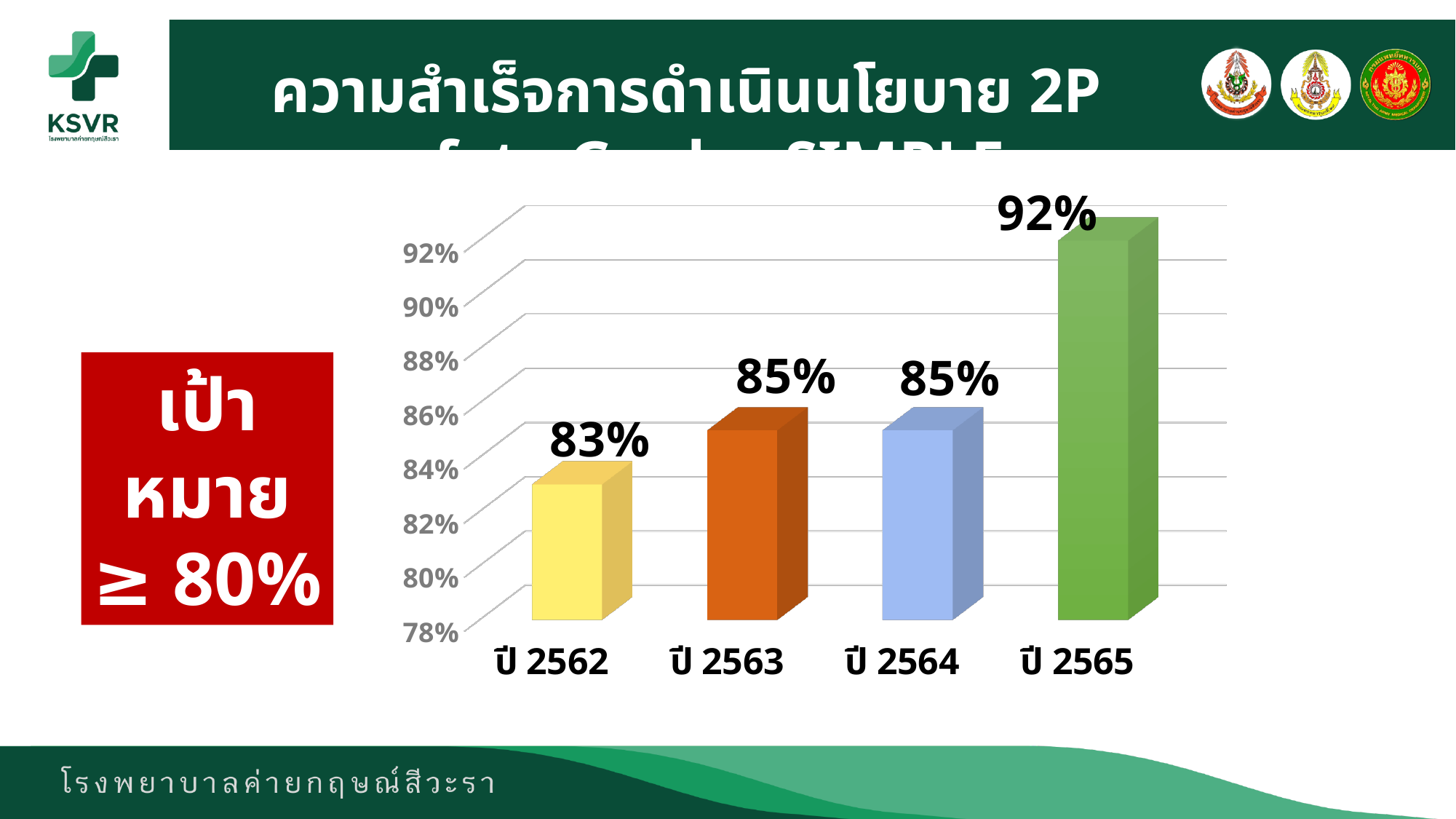
What is the value for ปี 2565? 92% Which year has the lowest value? ปี 2562 Which is larger, the value for ปี 2564 or the value for ปี 2565? ปี 2565 How many years are shown on the chart? 4 What is the difference between the values for ปี 2563 and ปี 2562? 2% Do the values rise or fall from ปี 2562 to ปี 2565? rise What is the value for ปี 2563? 85% Is the value for ปี 2565 greater or less than 90%? greater Which year has the highest value? ปี 2565 What kind of chart is shown on the slide? bar chart What is the difference between the values for ปี 2565 and ปี 2562? 9% What is the value for ปี 2562? 83%